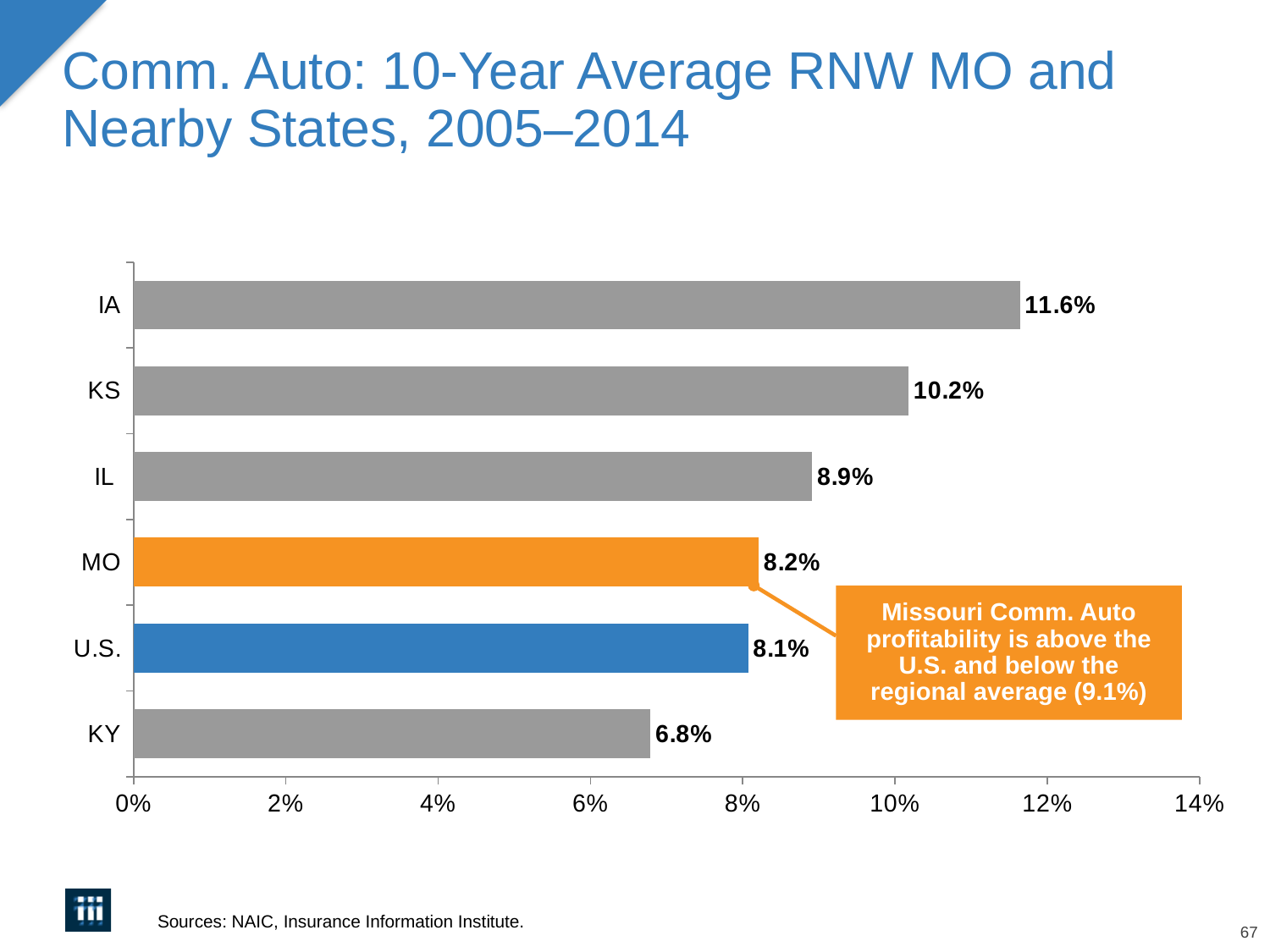
What is the value shown for KY? 6.8% According to the callout, what is the regional average? 9.1% How many bars are shown on the chart? 6 Which state has the highest 10-year average RNW? IA What kind of chart is shown on the slide? Bar chart What is the value shown for the U.S.? 8.1% What is the 10-year average RNW for IA? 11.6% Which category has the lowest value on the chart? KY What is the difference between the values for MO and KY? 1.4% What is the difference between the values for IA and KS? 1.4% Which has a larger value, KS or IL? KS What is the 10-year average RNW for MO? 8.2%